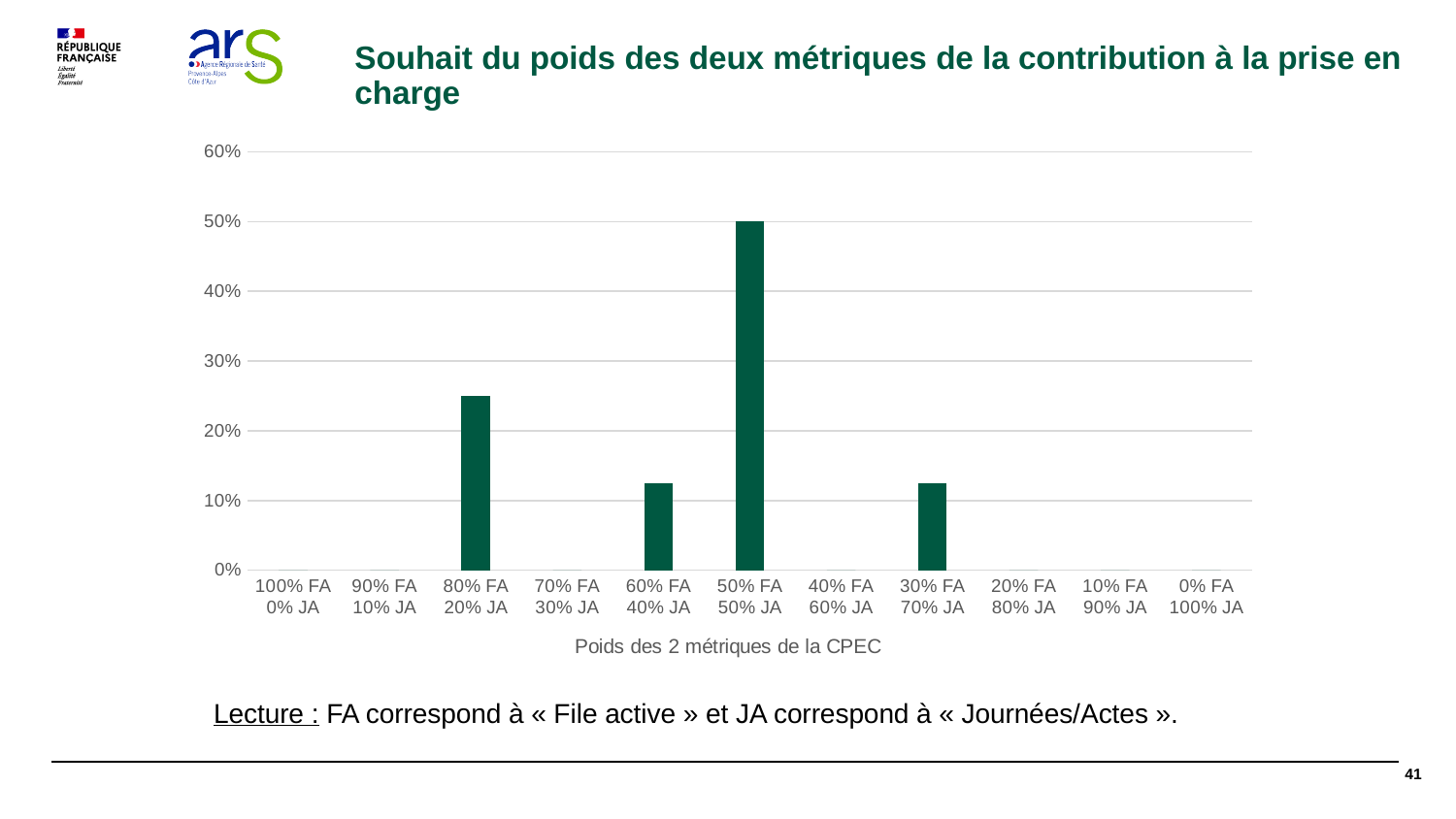
How many categories are shown on the x axis? 11 Which is larger, the value for "80% FA 20% JA" or the value for "60% FA 40% JA"? 80% FA 20% JA Is the value for "60% FA 40% JA" greater or less than 10%? greater Which category has the highest value? 50% FA 50% JA Is the value for "80% FA 20% JA" greater or less than 30%? less How many categories have a visible (non-zero) bar? 4 What is the title of the chart? Souhait du poids des deux métriques de la contribution à la prise en charge What is the value for the category "50% FA 50% JA"? 50% Is the value for "80% FA 20% JA" greater or less than 20%? greater What kind of chart is shown on the slide? bar chart What is the label of the x axis? Poids des 2 métriques de la CPEC